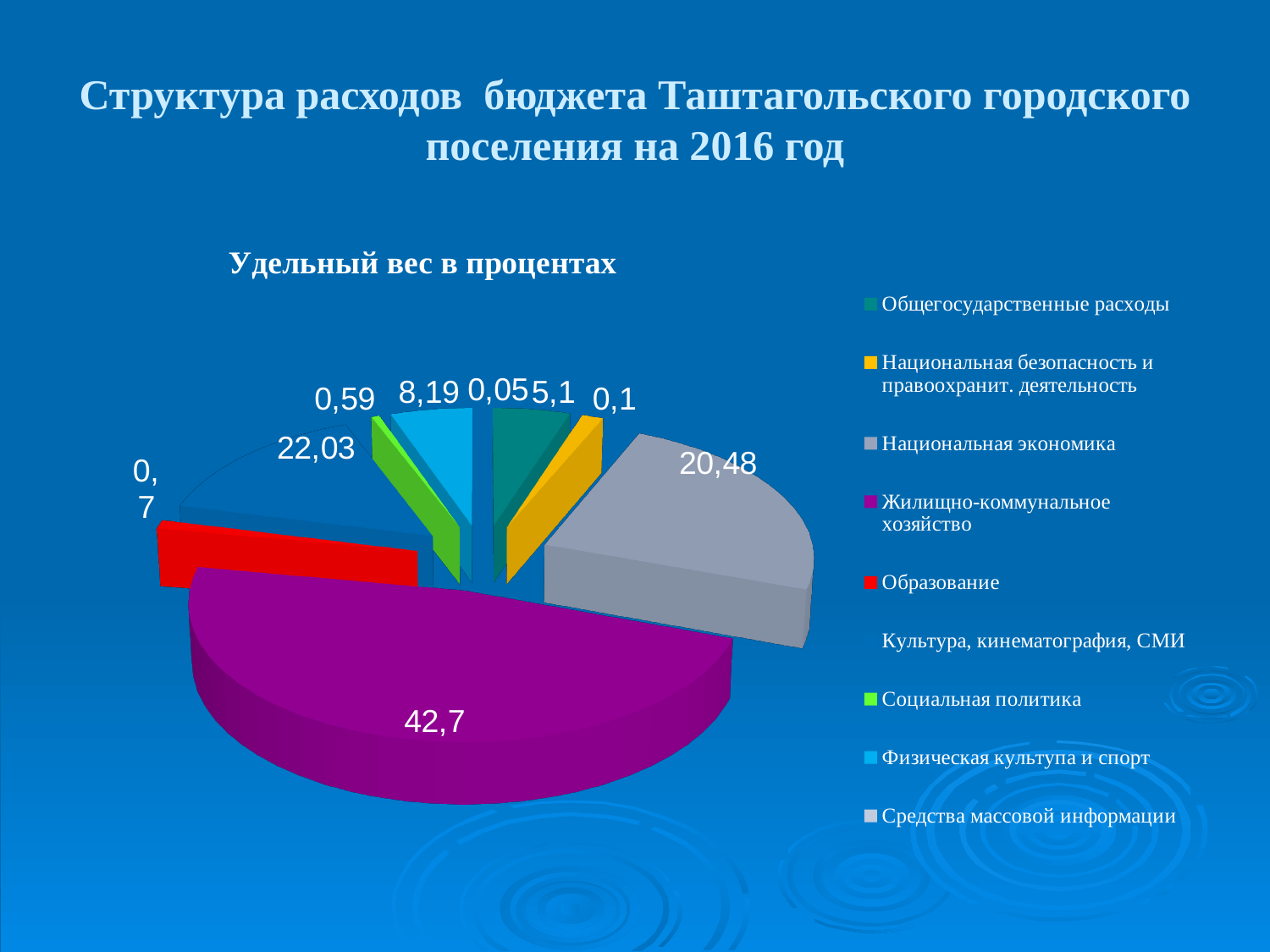
What is the value shown for Национальная экономика? 20,48 What is the value shown for Физическая культупа и спорт? 8,19 What is the title of the chart? Удельный вес в процентах What colour is the slice for Жилищно-коммунальное хозяйство? purple What kind of chart is shown on the slide? pie chart How many categories does the legend list? 9 What is the value shown for Жилищно-коммунальное хозяйство? 42,7 Which category has the largest share of the pie? Жилищно-коммунальное хозяйство What is the value shown for Общегосударственные расходы? 5,1 What is the smallest value labelled on the pie? 0,05 What is the difference between the values for Жилищно-коммунальное хозяйство and Национальная экономика? 22,22 Which is larger, the value for Национальная экономика or the value for Физическая культупа и спорт? Национальная экономика